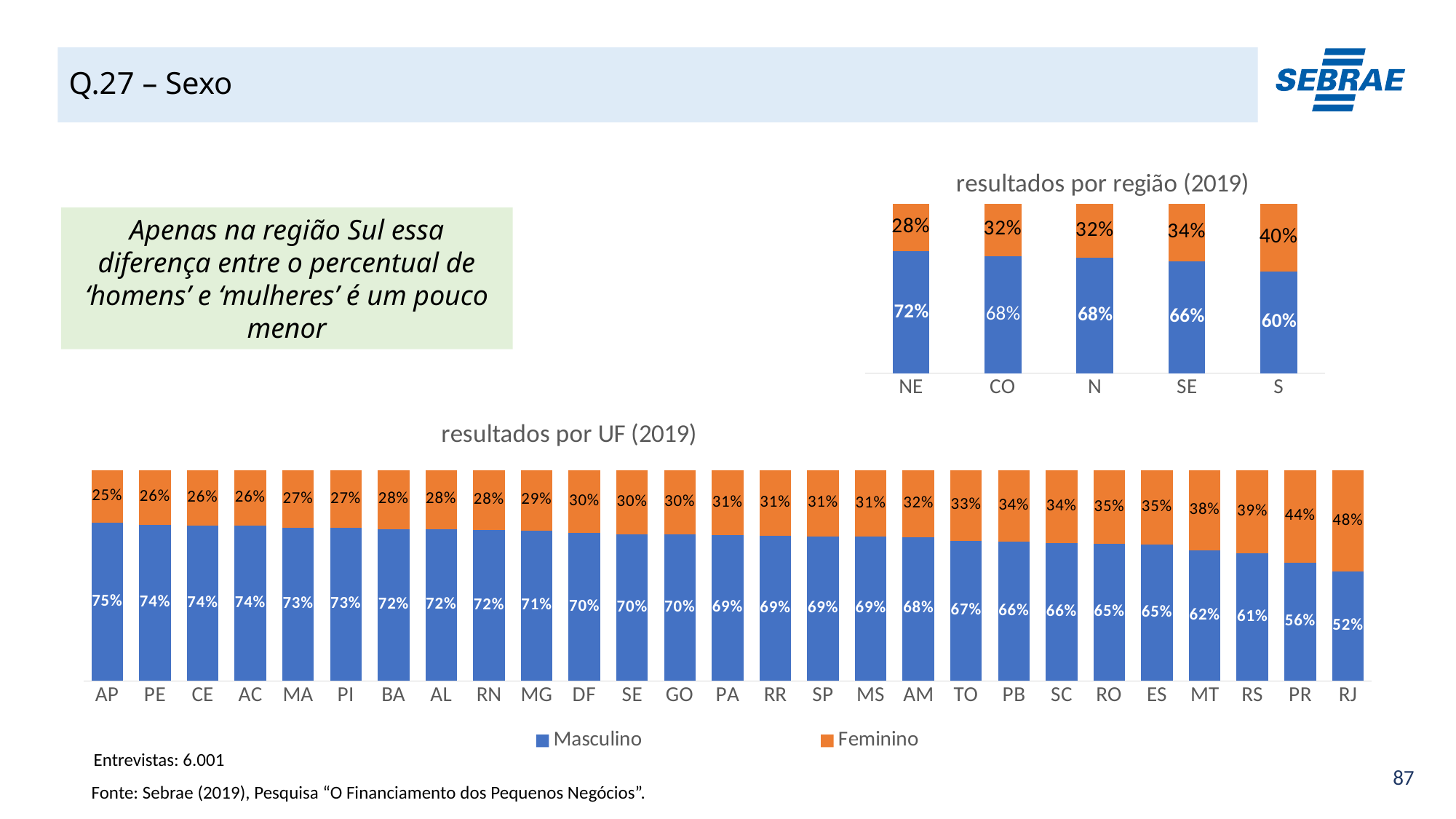
In the 'resultados por UF (2019)' chart, do the Masculino values rise or fall from AP to RJ along the x axis? Fall In the 'resultados por região (2019)' chart, what is the Feminino value for S? 40% How many series does the legend of the 'resultados por UF (2019)' chart list? 2 In the 'resultados por UF (2019)' chart, which is larger, the Feminino value for PR or for RS? PR What kind of chart is 'resultados por UF (2019)'? Stacked bar chart In the 'resultados por UF (2019)' chart, what is the Masculino value for MT? 62% In the 'resultados por UF (2019)' chart, what is the Feminino value for RJ? 48% In the 'resultados por UF (2019)' chart, how many UFs are shown on the x axis? 27 In the 'resultados por UF (2019)' chart, which UF has the highest Masculino value? AP In the 'resultados por região (2019)' chart, what is the Masculino value for NE? 72% In the 'resultados por região (2019)' chart, what is the difference between the Masculino values for NE and SE? 6% In the 'resultados por região (2019)' chart, which region has the lowest Masculino value? S